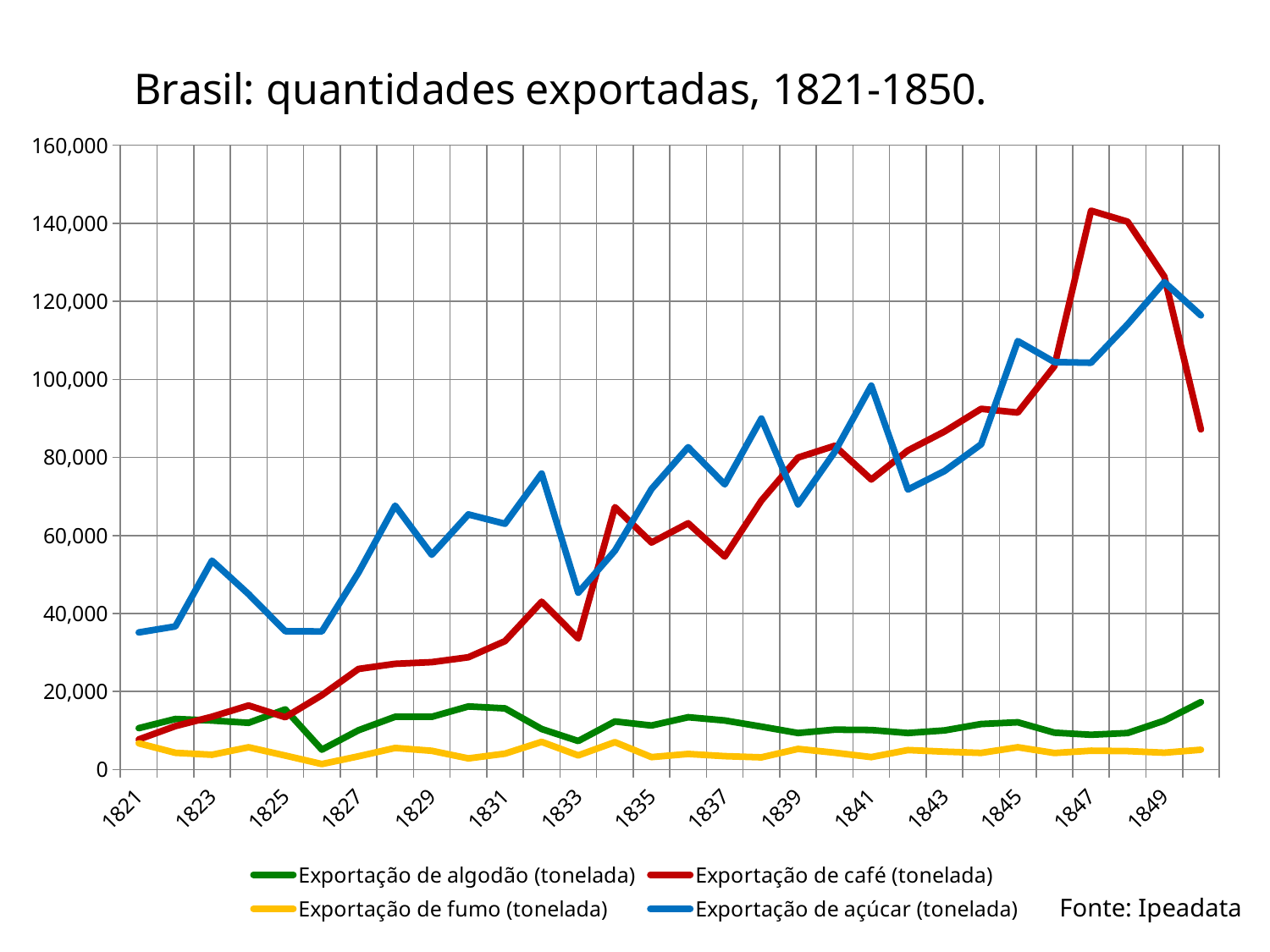
How many years are plotted along the x axis? 30 What kind of chart is shown on the slide? line chart Is the value for Exportação de café in 1821 greater or less than 20,000? less Is the value for Exportação de açúcar in 1849 greater or less than 100,000? greater Is the value for Exportação de açúcar in 1821 greater or less than 40,000? less Which series has the highest value in 1847? Exportação de café (tonelada) Which series is drawn in blue? Exportação de açúcar (tonelada) Which series has the lowest values across the whole period? Exportação de fumo (tonelada) In 1850, which is larger: Exportação de café or Exportação de açúcar? Exportação de açúcar How many series does the legend list? 4 What is the title of the chart? Brasil: quantidades exportadas, 1821-1850.